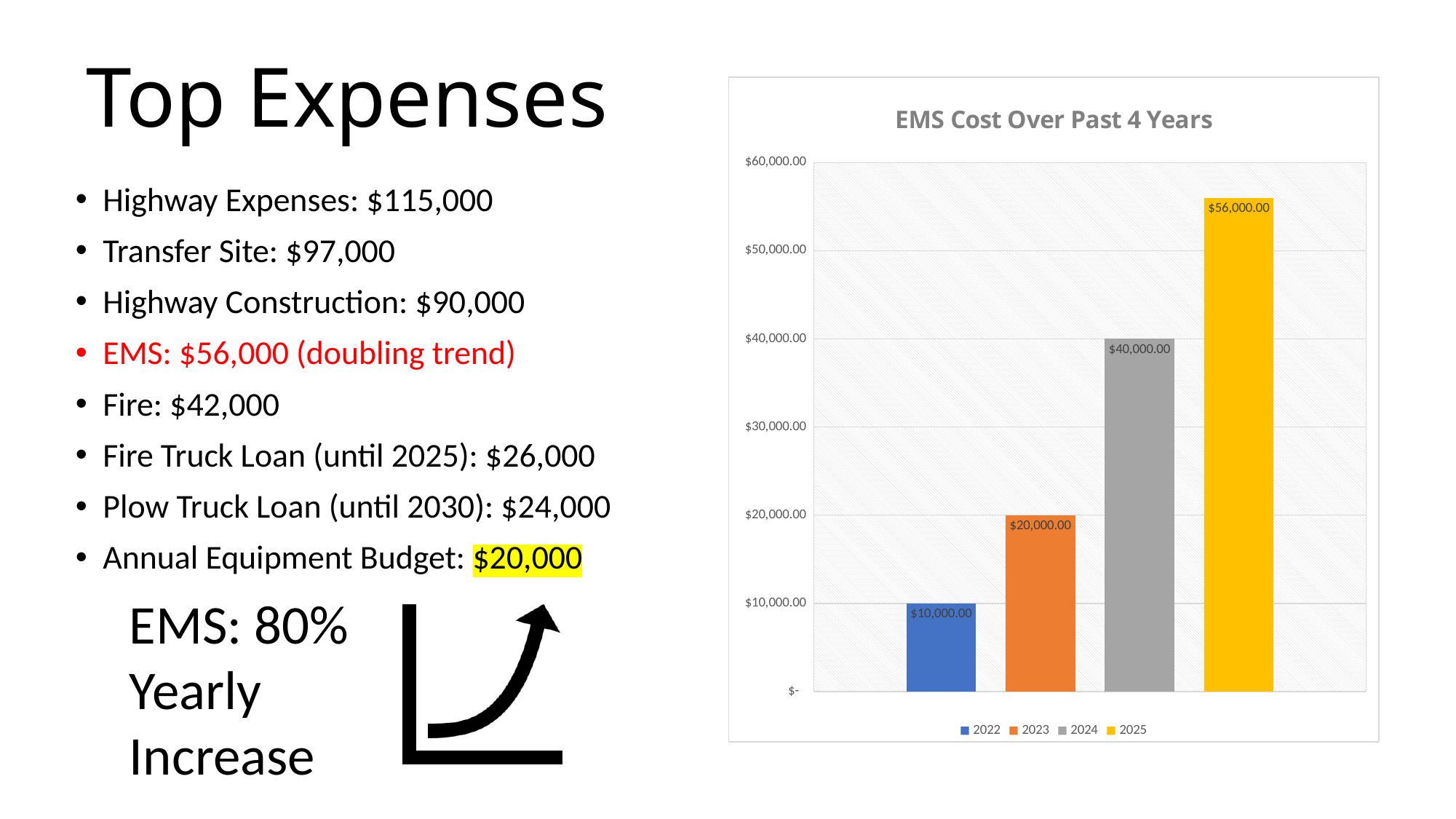
How many years are plotted in the chart? 4 What is the EMS cost for 2024 in the chart? $40,000.00 Do the EMS costs rise or fall from 2022 to 2025? rise What is the EMS cost for 2025 in the chart? $56,000.00 Which is larger, the EMS cost in 2023 or in 2024? 2024 Is the EMS cost for 2025 greater or less than $50,000.00? greater How many entries does the chart legend list? 4 Which year has the lowest EMS cost in the chart? 2022 Which year has the highest EMS cost in the chart? 2025 What is the EMS cost for 2022 in the chart? $10,000.00 What is the difference between the EMS cost in 2025 and in 2024? $16,000.00 What kind of chart is shown on the slide? bar chart